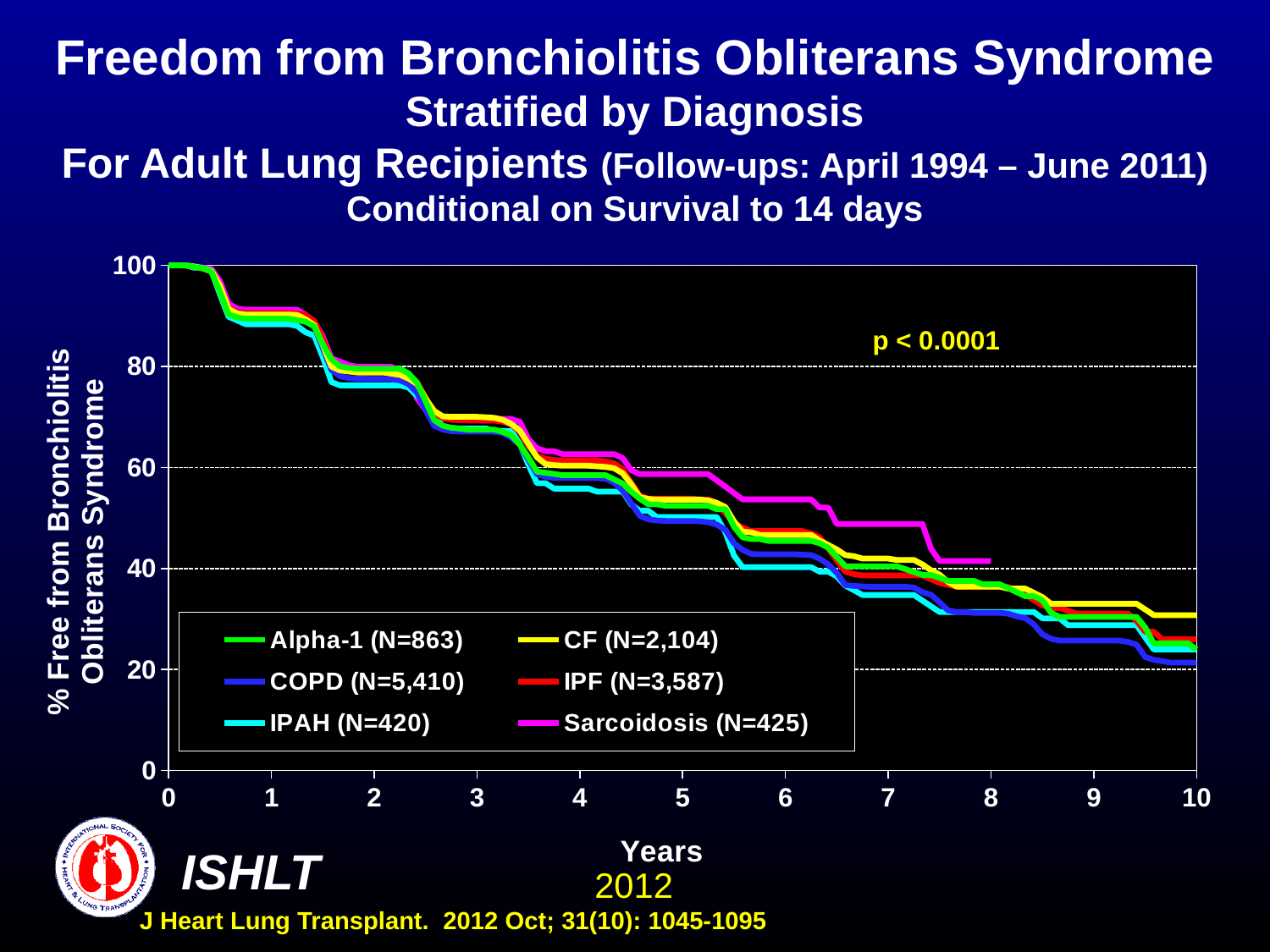
Is the value for Sarcoidosis at 7 years greater or less than 40? greater At 7 years, which is larger: the value for Sarcoidosis or the value for COPD? Sarcoidosis How many series does the legend list? 6 Is the value for IPAH at 2 years greater or less than 80? less Which series has the highest value at 10 years? CF (N=2,104) What is the N for the CF series shown in the legend? 2,104 Do the curves rise or fall as the years increase along the x axis? fall What is the N for the COPD series shown in the legend? 5,410 What p-value is printed on the chart? p < 0.0001 Is the value for COPD at 10 years greater or less than 40? less Which series has the lowest value at 10 years? COPD (N=5,410) What kind of chart is shown on the slide? line chart